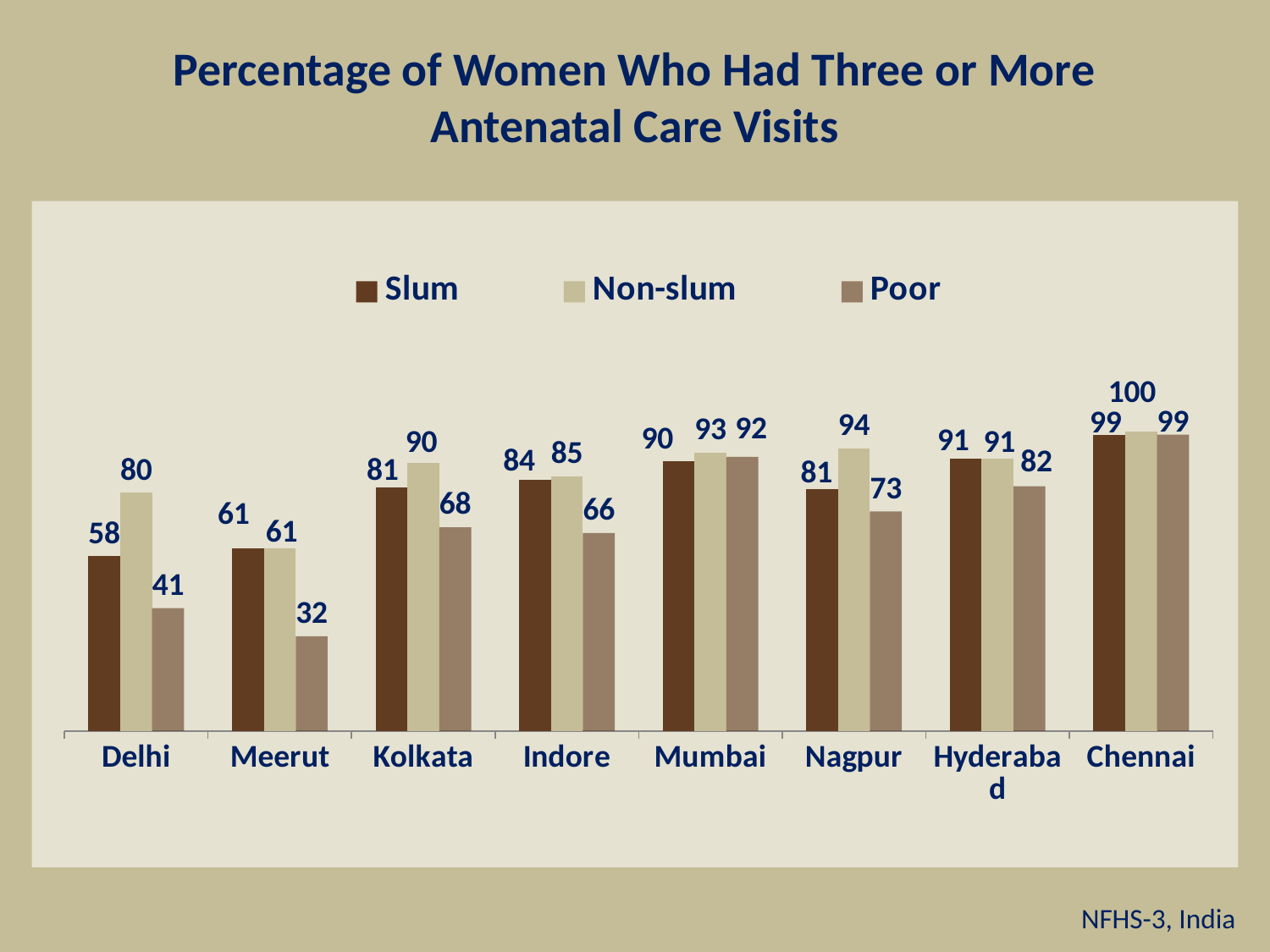
Which city has the highest Non-slum value? Chennai How many cities are shown on the x axis? 8 What is the Non-slum value for Nagpur? 94 What is the difference between the Non-slum and Poor values for Delhi? 39 Which is larger, the Slum value for Kolkata or the Slum value for Mumbai? Mumbai What is the difference between the Slum and Poor values for Nagpur? 8 Which city has the lowest Poor value? Meerut What is the Slum value for Delhi? 58 What is the Poor value for Meerut? 32 What is the title of the chart? Percentage of Women Who Had Three or More Antenatal Care Visits How many series does the legend list? 3 What kind of chart is shown? bar chart